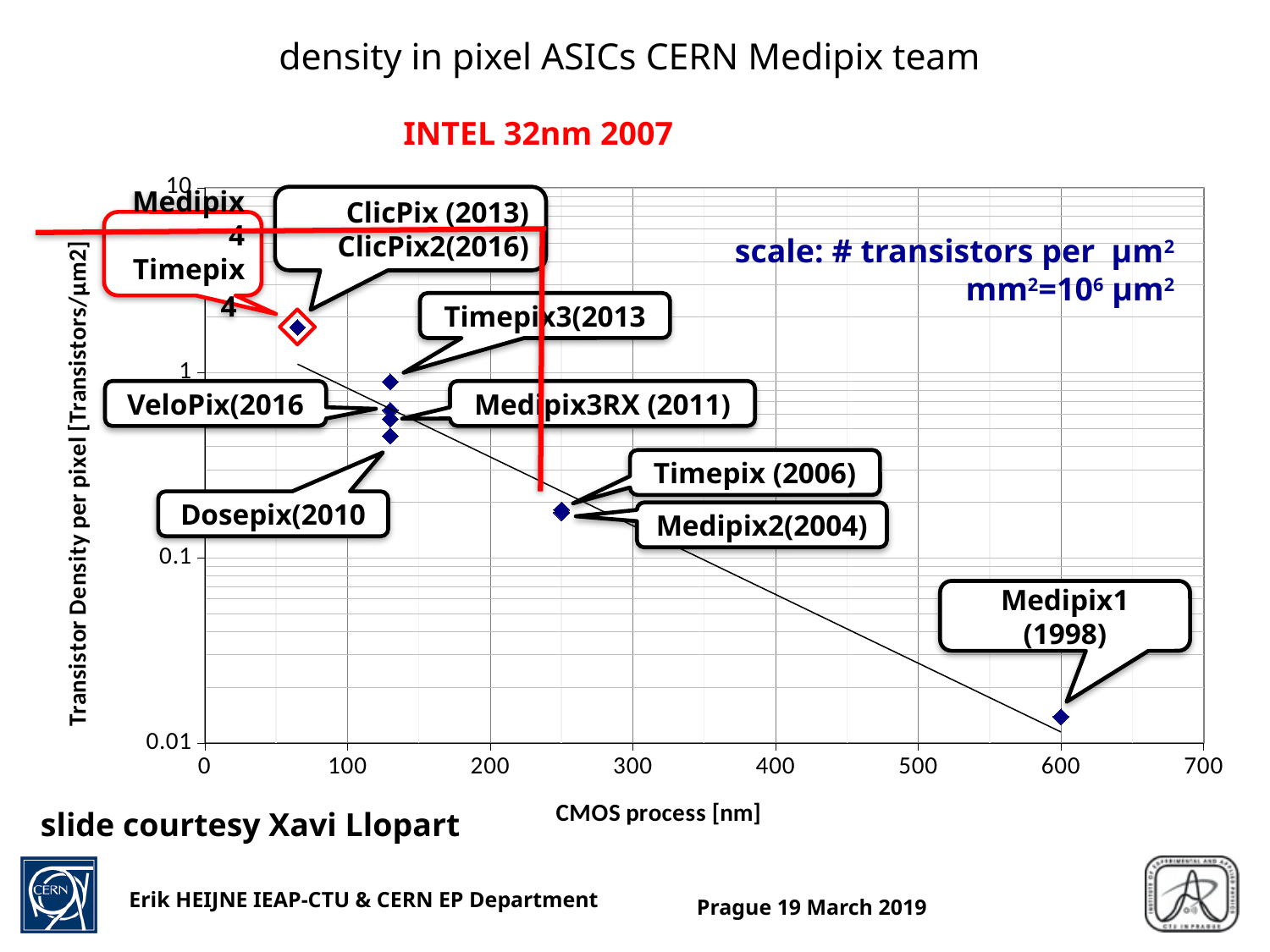
What is the title of the x axis of the chart? CMOS process [nm] Is the CMOS process value for Timepix (2006) greater or less than 300 nm? less As the CMOS process value increases along the x axis, does the transistor density per pixel rise or fall? fall What is the CMOS process value, in nm, for Medipix1 (1998)? 600 What kind of chart is shown on the slide? scatter chart Which labelled chip uses the largest CMOS process node? Medipix1 (1998) What is the title of the y axis of the chart? Transistor Density per pixel [Transistors/µm2] Which labelled chip has the lowest transistor density per pixel? Medipix1 (1998) Which has the higher transistor density per pixel, Timepix3 (2013) or Medipix1 (1998)? Timepix3 (2013) Is the transistor density for Timepix3 (2013) greater or less than 0.1? greater Which labelled chip has the highest transistor density per pixel? ClicPix (2013) / ClicPix2 (2016) Is the transistor density for Medipix1 (1998) greater or less than 0.1? less